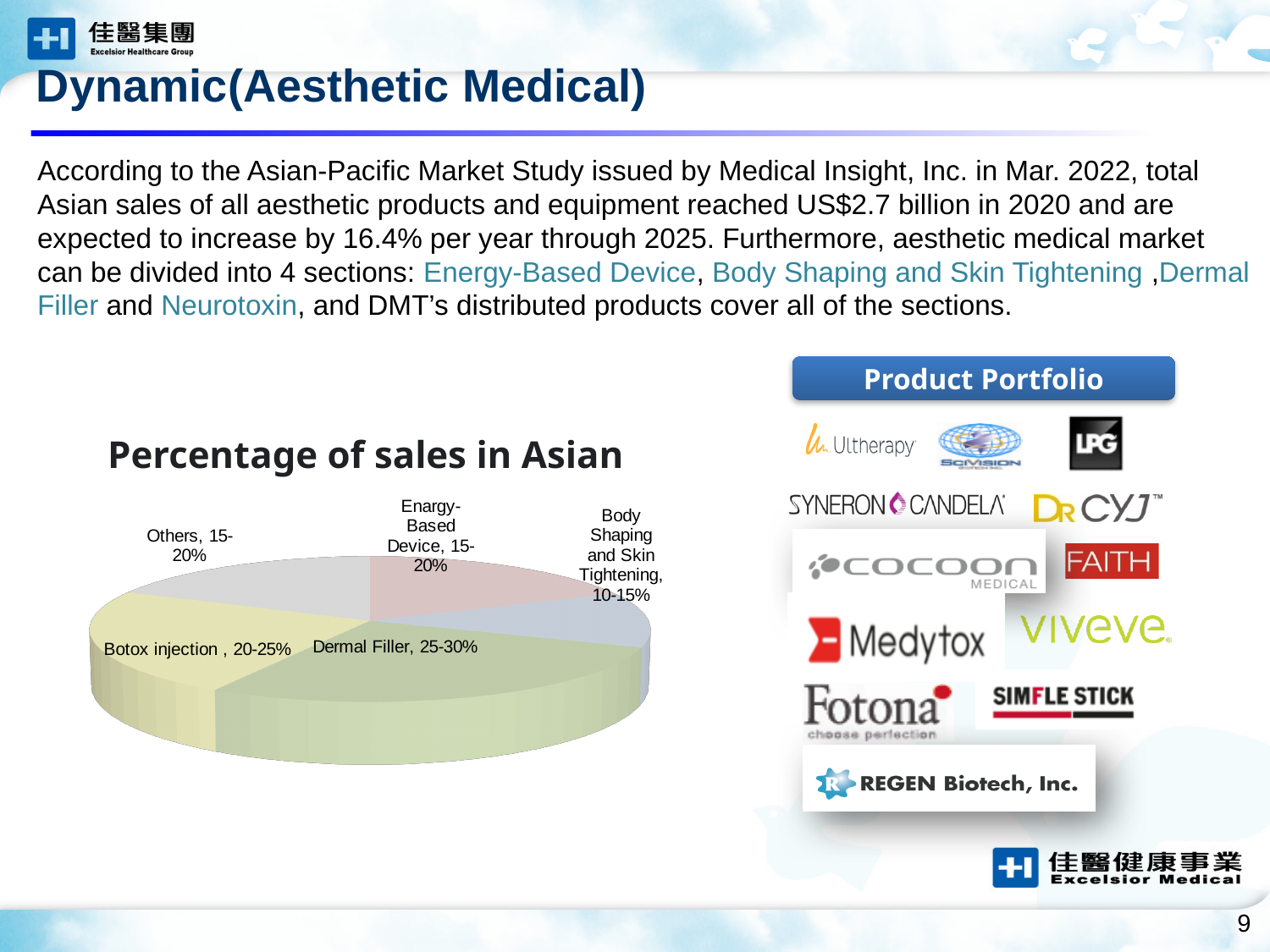
What percentage range is shown for Others in the pie chart? 15-20% Which category has the smallest share in the pie chart? Body Shaping and Skin Tightening What percentage range is shown for Body Shaping and Skin Tightening in the pie chart? 10-15% In the pie chart, which has the larger share: Botox injection or Body Shaping and Skin Tightening? Botox injection How many slices does the pie chart have? 5 What kind of chart is shown under the title "Percentage of sales in Asian"? Pie chart In the pie chart, which has the larger share: Dermal Filler or Body Shaping and Skin Tightening? Dermal Filler Which category has the largest share in the pie chart? Dermal Filler What percentage range is shown for Botox injection in the pie chart? 20-25% What is the title of the pie chart on the slide? Percentage of sales in Asian What percentage range is shown for Dermal Filler in the pie chart? 25-30% What percentage range is shown for Enargy-Based Device in the pie chart? 15-20%